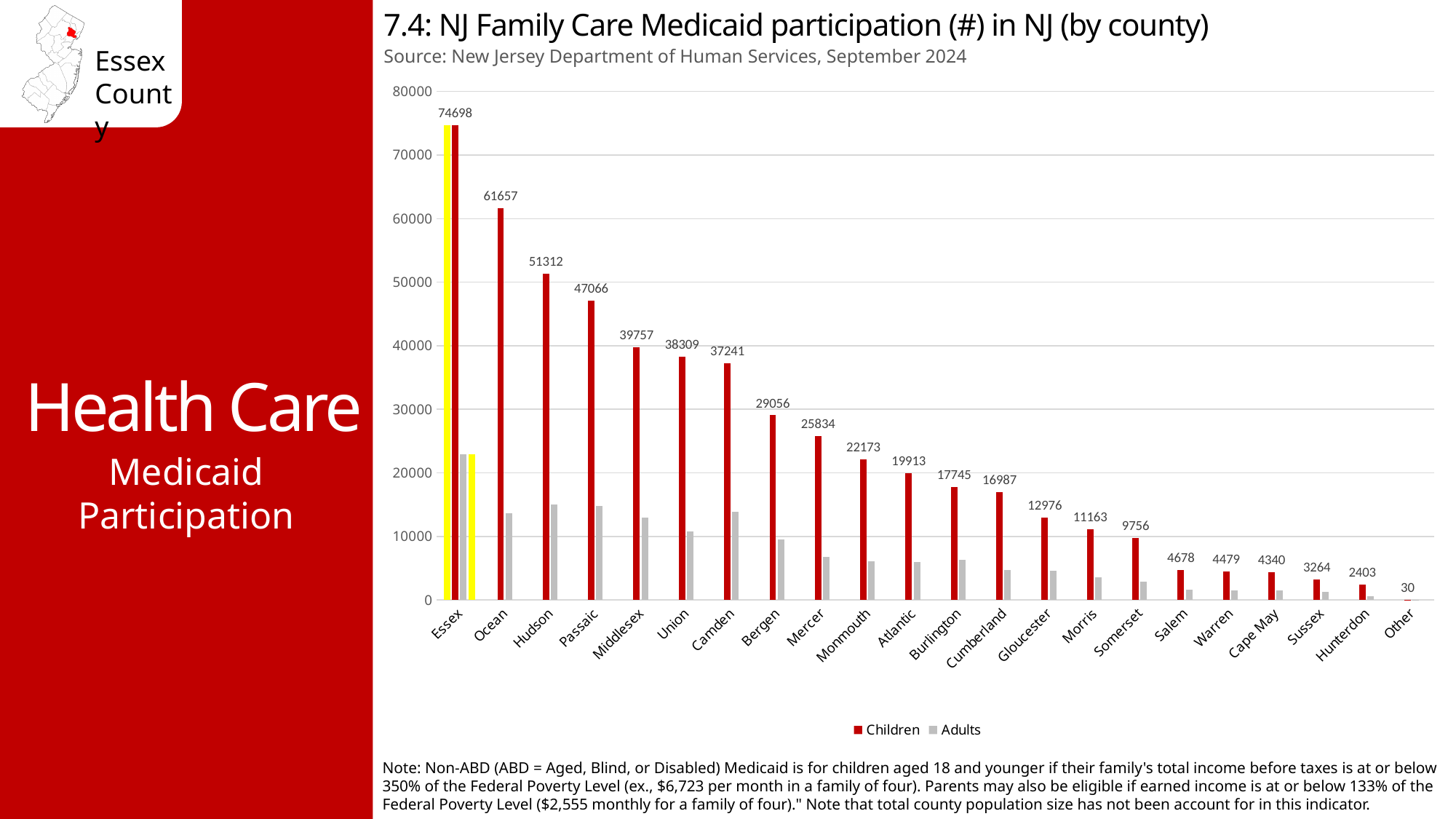
What is the Children value for Monmouth? 22173 What is the Children value for Hudson? 51312 What is the difference between the Children values for Ocean and Hudson? 10345 What is the Children value for Essex? 74698 What kind of chart is shown? Bar chart How many series does the legend list? 2 Which has a larger Children value, Bergen or Mercer? Bergen Is the Adults value for Essex greater or less than 20000? greater Which category has the lowest Children value? Other How many categories are shown on the x axis? 22 Which county has the highest Children value? Essex Is the Adults value for Ocean greater or less than 20000? less